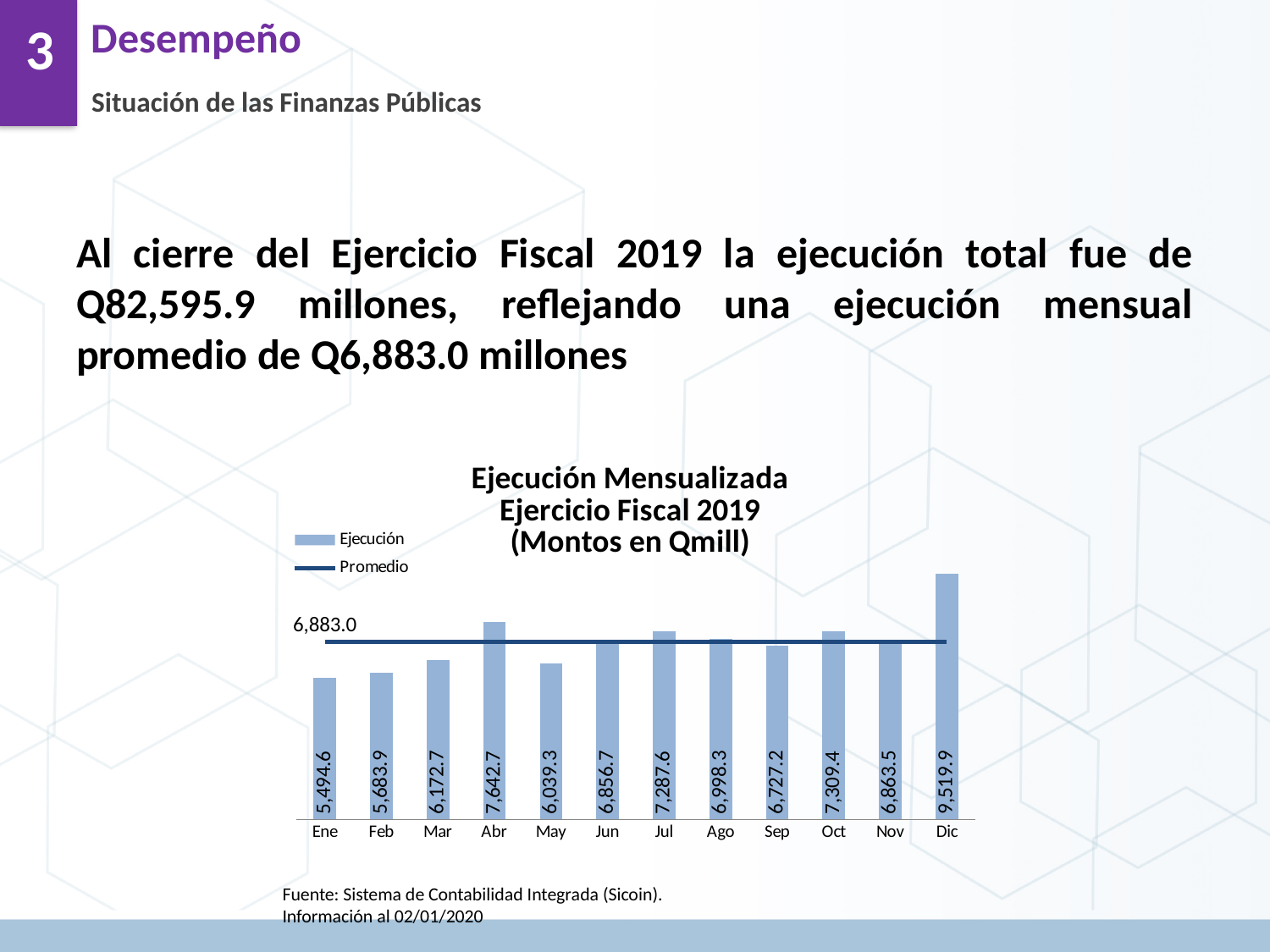
Do the values rise or fall from Ene to Abr in the Ejecución Mensualizada chart? Rise What is the difference between the values for Dic and Ene in the Ejecución Mensualizada chart? 4,025.3 Which month has the lowest value in the Ejecución Mensualizada chart? Ene What kind of chart is the Ejecución Mensualizada chart? Combination bar and line chart What is the value for Sep in the Ejecución Mensualizada chart? 6,727.2 Which is larger in the Ejecución Mensualizada chart, the value for Abr or the value for Jul? Abr What value is labelled on the Promedio line in the Ejecución Mensualizada chart? 6,883.0 Which month has the highest value in the Ejecución Mensualizada chart? Dic What is the value for Abr in the Ejecución Mensualizada chart? 7,642.7 How many series does the legend of the Ejecución Mensualizada chart list? 2 What is the difference between the values for Abr and Mar in the Ejecución Mensualizada chart? 1,470.0 How many months are shown on the x axis of the Ejecución Mensualizada chart? 12